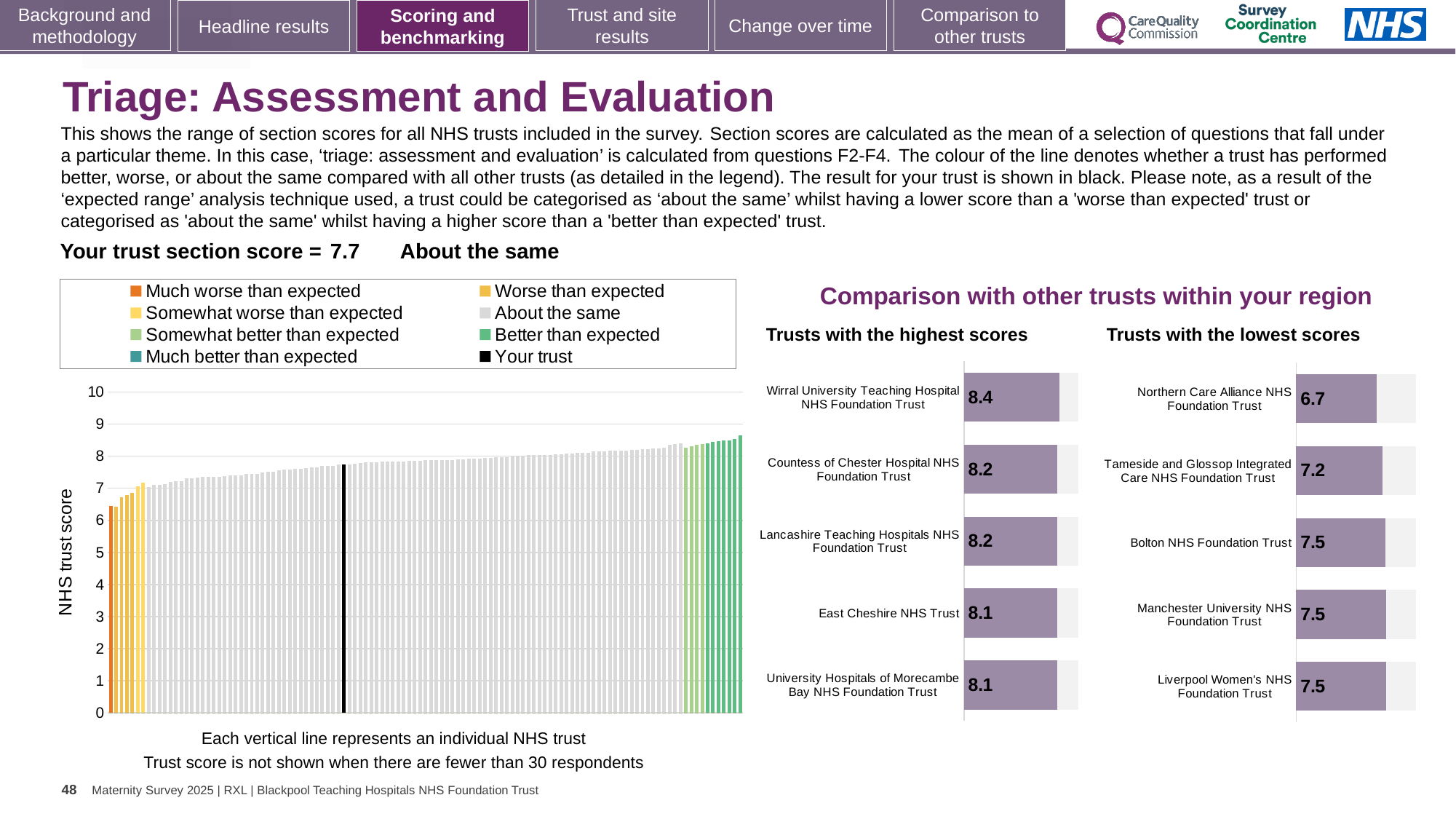
How many entries does the legend of the main 'NHS trust score' chart list? 8 In the main 'NHS trust score' chart, do the values rise or fall from left to right? Rise In the 'Trusts with the highest scores' chart, which trust has the highest score? Wirral University Teaching Hospital NHS Foundation Trust In the 'Trusts with the lowest scores' chart, which trust has the lowest score? Northern Care Alliance NHS Foundation Trust In the 'Trusts with the lowest scores' chart, what is the score for Northern Care Alliance NHS Foundation Trust? 6.7 In the 'Trusts with the lowest scores' chart, what is the score for Tameside and Glossop Integrated Care NHS Foundation Trust? 7.2 In the 'Trusts with the highest scores' chart, what is the score for Wirral University Teaching Hospital NHS Foundation Trust? 8.4 In the 'Trusts with the lowest scores' chart, what is the difference between the scores of Bolton NHS Foundation Trust and Northern Care Alliance NHS Foundation Trust? 0.8 In the 'Trusts with the highest scores' chart, what is the difference between the scores of Wirral University Teaching Hospital NHS Foundation Trust and East Cheshire NHS Trust? 0.3 In the 'Trusts with the lowest scores' chart, which has the larger score: Tameside and Glossop Integrated Care NHS Foundation Trust or Bolton NHS Foundation Trust? Bolton NHS Foundation Trust What kind of chart is the main 'NHS trust score' chart on the left? Bar chart How many trusts are shown in the 'Trusts with the highest scores' chart? 5